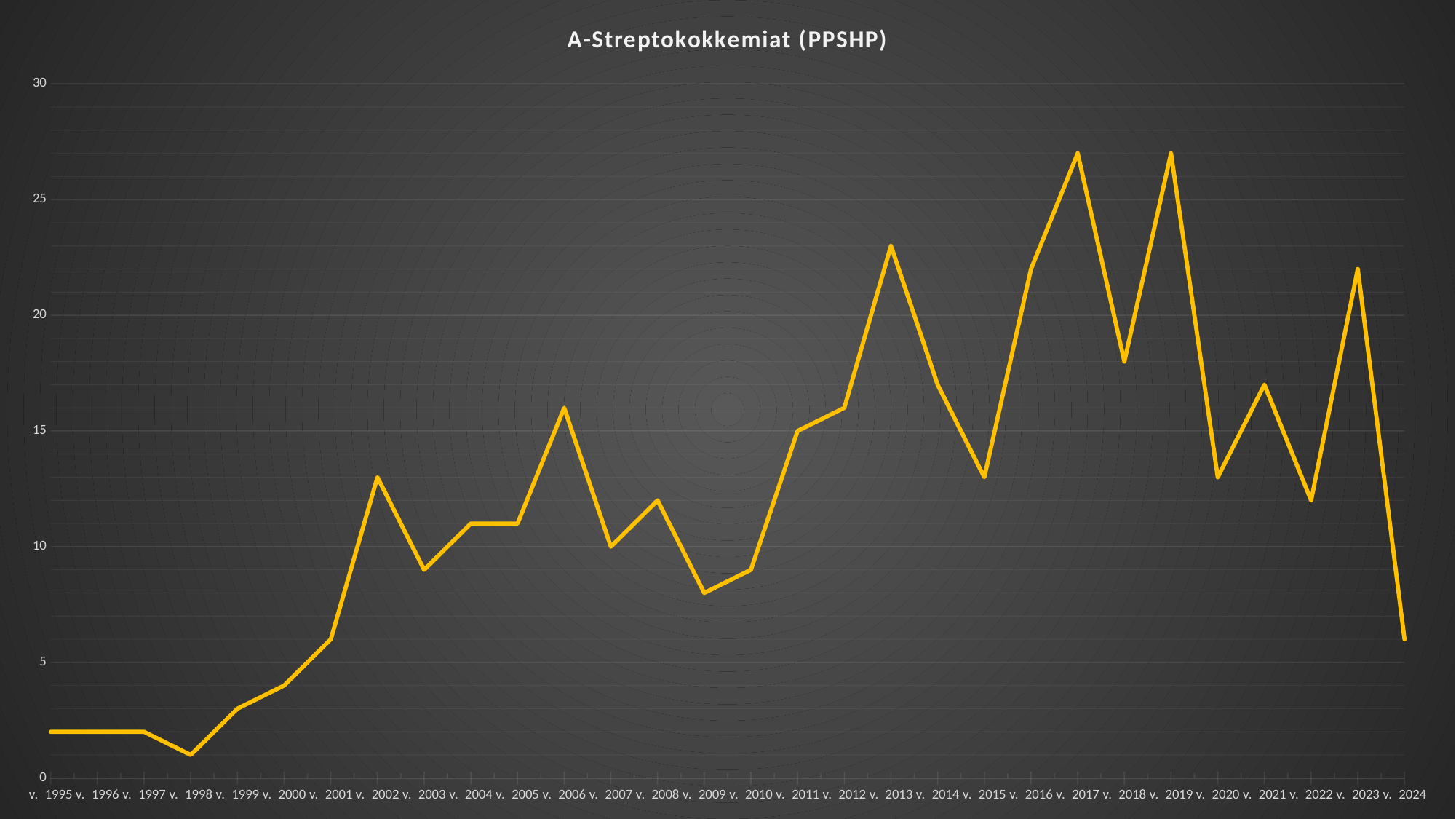
What is the title of the chart? A-Streptokokkemiat (PPSHP) Which is larger, the value for 2013 or the value for 2015? 2013 Is the value for 2009 greater or less than 10? less Is the value for 2013 greater or less than 20? greater Which is larger, the value for 2023 or the value for 2024? 2023 Do the values rise or fall from 1998 to 2002? rise Which year has the lowest value? 1998 Is the value for 2024 greater or less than 10? less How many years are plotted along the x axis? 30 What kind of chart is shown on the slide? line chart